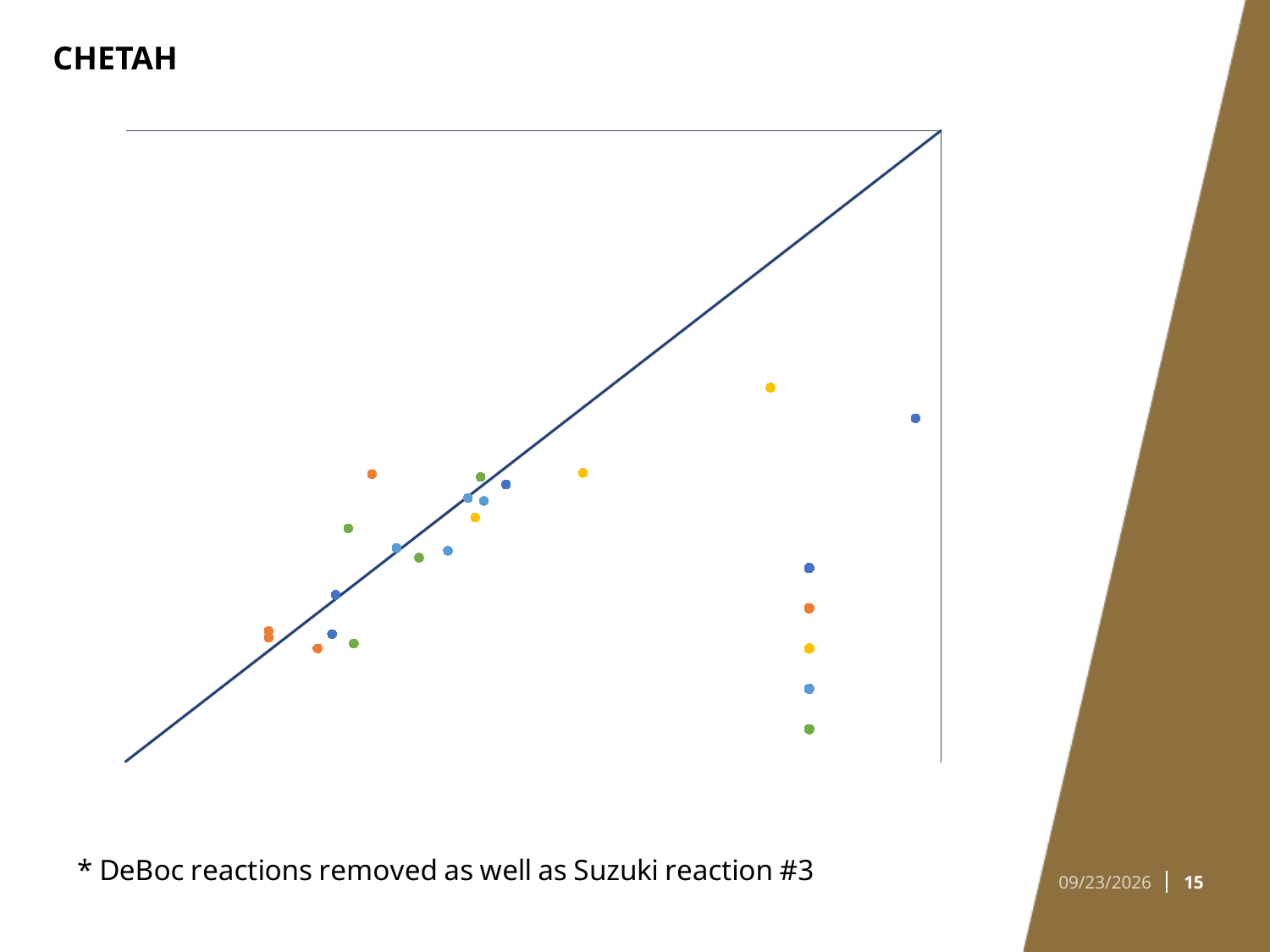
What kind of chart is shown on the slide? scatter chart How many series (distinct marker colours) does the legend on the right of the chart show? 5 What is the title shown above the chart on the slide? CHETAH What does the straight line drawn across the chart run from and to? from the bottom-left corner to the top-right corner (a diagonal) Do the plotted points generally rise or fall as you move from left to right along the x axis? rise